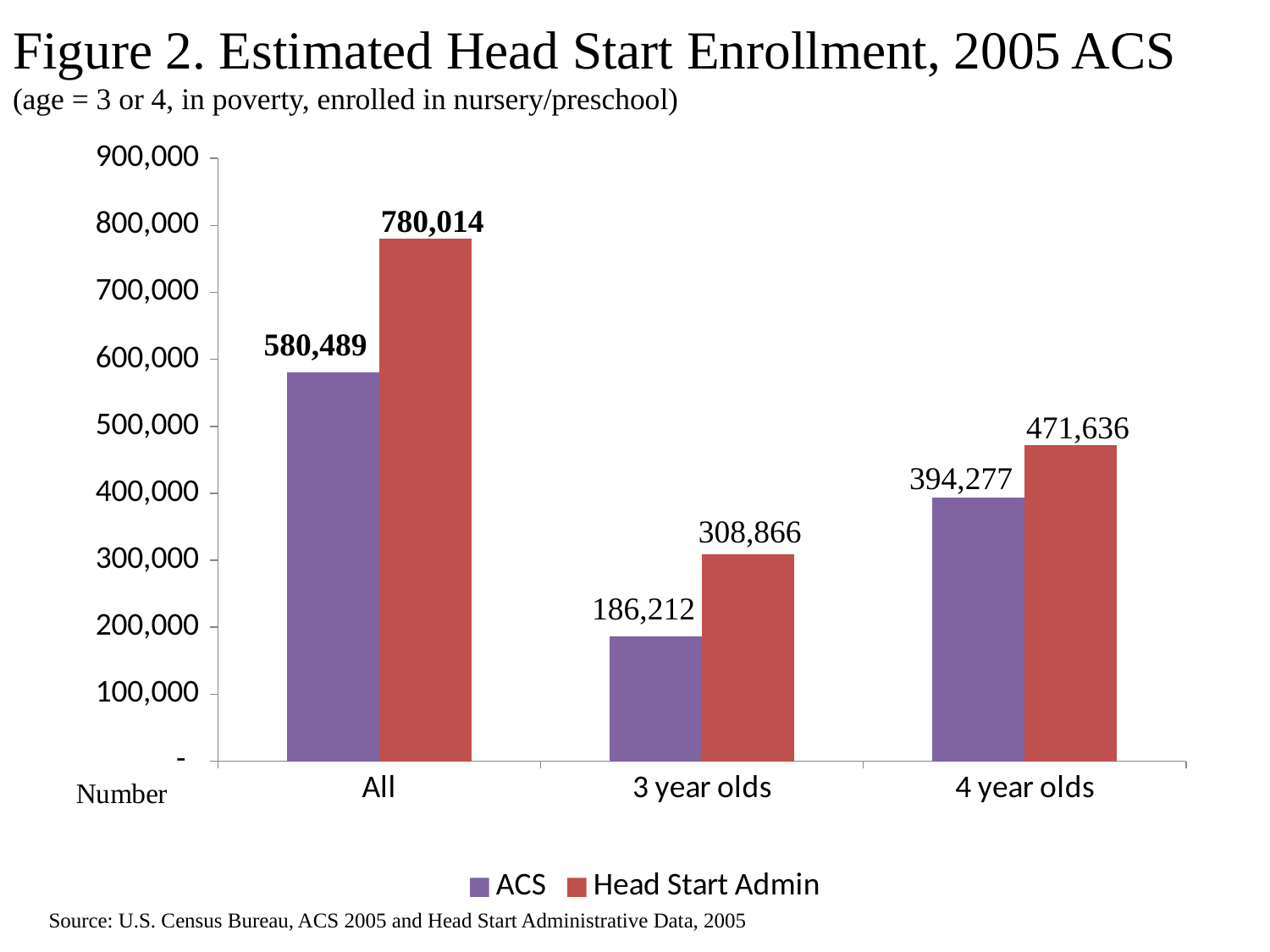
How many series does the legend list? 2 Which category has the highest Head Start Admin value? All What kind of chart is shown on the slide? bar chart What is the ACS value for All? 580,489 What is the ACS value for 4 year olds? 394,277 How many categories are shown on the x axis? 3 Which is larger for 3 year olds, the ACS value or the Head Start Admin value? Head Start Admin What is the Head Start Admin value for 3 year olds? 308,866 Is the ACS value for 3 year olds greater or less than 200,000? less What is the difference between the Head Start Admin and ACS values for 4 year olds? 77,359 What is the difference between the Head Start Admin and ACS values for All? 199,525 Which category has the lowest ACS value? 3 year olds